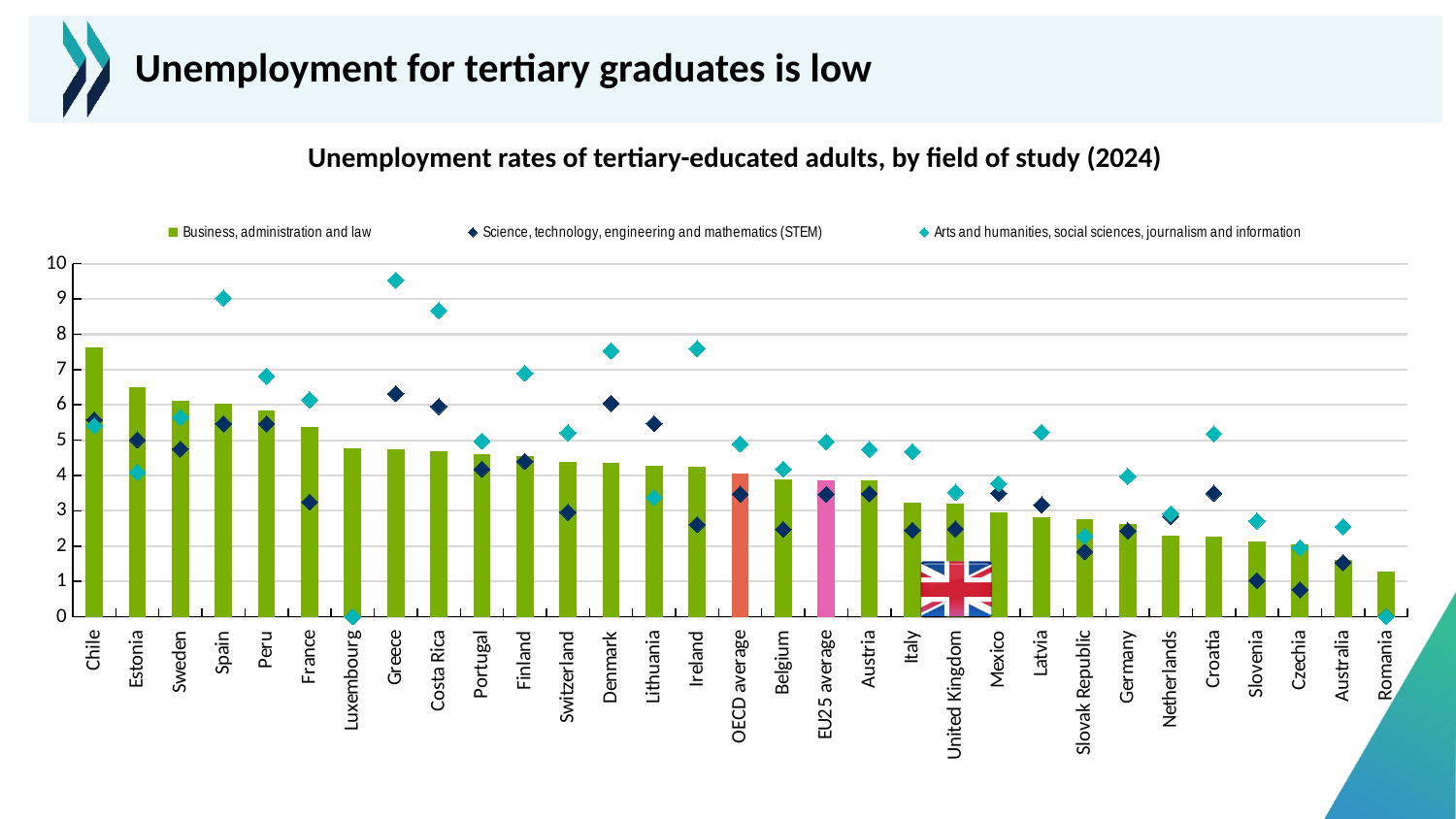
Is the Arts and humanities, social sciences, journalism and information value for Greece greater or less than 9? greater How many countries or groups are shown along the x axis? 31 How many series does the legend list? 3 Which country has the highest bar for Business, administration and law? Chile Which country has the lowest bar for Business, administration and law? Romania Is the Business, administration and law value for Chile greater or less than 7? greater What is the title of the chart? Unemployment rates of tertiary-educated adults, by field of study (2024) Is the STEM value for Czechia greater or less than 1? less Which country has the highest marker for Arts and humanities, social sciences, journalism and information? Greece What kind of chart is shown on the slide? bar chart Do the Business, administration and law bars rise or fall from left to right along the x axis? fall